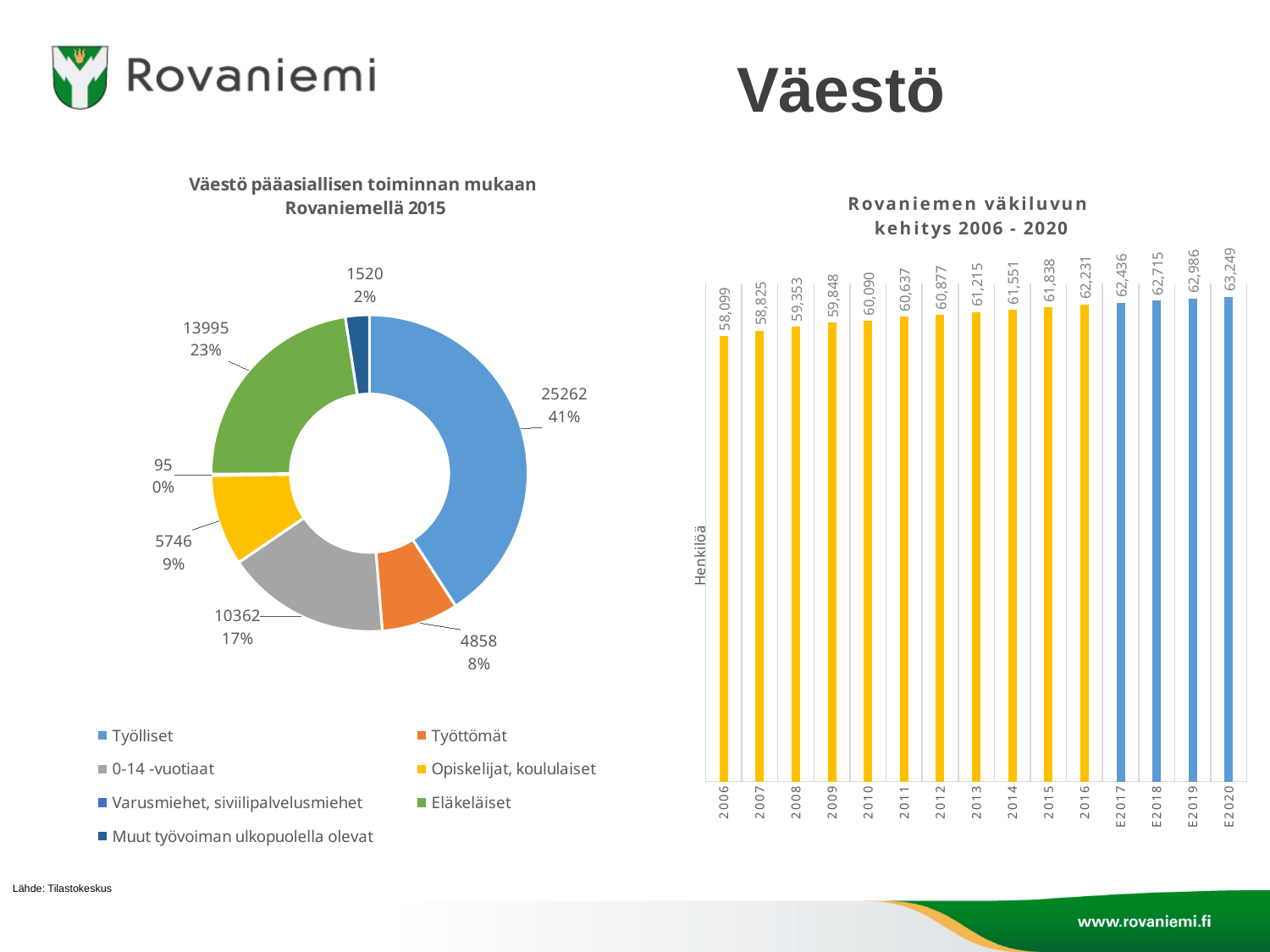
In the chart 'Rovaniemen väkiluvun kehitys 2006 - 2020', which year has the lowest value? 2006 In the chart 'Väestö pääasiallisen toiminnan mukaan Rovaniemellä 2015', what share of the total do Eläkeläiset make up? 23% In the chart 'Rovaniemen väkiluvun kehitys 2006 - 2020', do the values rise or fall from 2006 to E2020? rise In the chart 'Väestö pääasiallisen toiminnan mukaan Rovaniemellä 2015', what is the value for Työlliset? 25262 In the chart 'Rovaniemen väkiluvun kehitys 2006 - 2020', what is the value for 2013? 61,215 In the chart 'Rovaniemen väkiluvun kehitys 2006 - 2020', what is the difference between the values for E2020 and 2006? 5,150 In the chart 'Väestö pääasiallisen toiminnan mukaan Rovaniemellä 2015', which is larger: 0-14 -vuotiaat or Opiskelijat, koululaiset? 0-14 -vuotiaat In the chart 'Rovaniemen väkiluvun kehitys 2006 - 2020', what is the value for 2006? 58,099 What kind of chart is 'Rovaniemen väkiluvun kehitys 2006 - 2020'? bar chart In the chart 'Väestö pääasiallisen toiminnan mukaan Rovaniemellä 2015', which category has the smallest value? Varusmiehet, siviilipalvelusmiehet In the chart 'Rovaniemen väkiluvun kehitys 2006 - 2020', what is the value for E2020? 63,249 How many years are shown on the x axis of the chart 'Rovaniemen väkiluvun kehitys 2006 - 2020'? 15